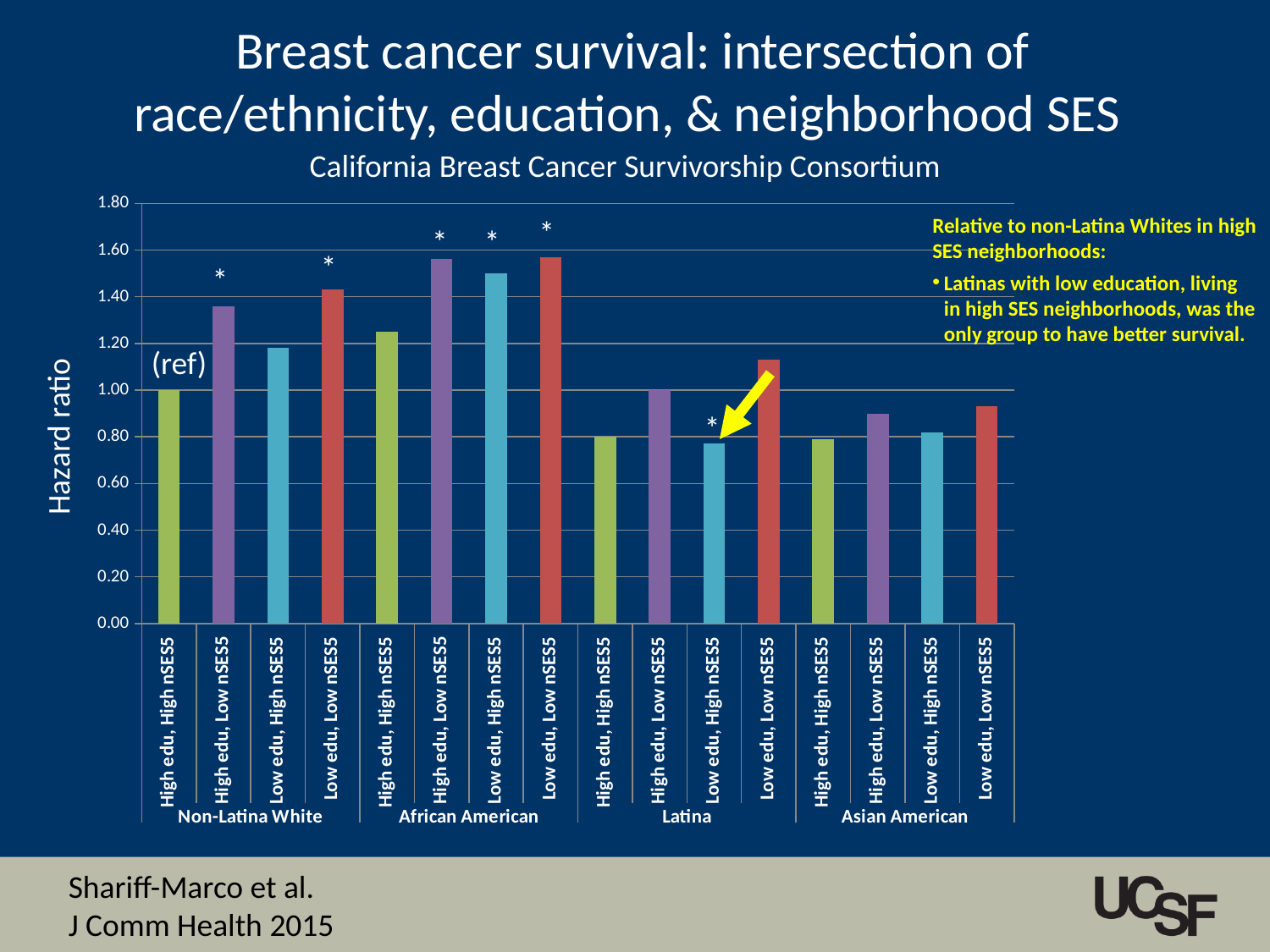
Is the hazard ratio for Latina, Low edu, High nSES greater or less than 1.00? less How many bars are plotted in the chart? 16 Which bar is marked as the reference group, labelled "(ref)"? Non-Latina White, High edu, High nSES5 Which has the higher hazard ratio: Non-Latina White, Low edu, Low nSES or Latina, Low edu, Low nSES? Non-Latina White, Low edu, Low nSES Is the hazard ratio for Asian American, High edu, Low nSES greater or less than 1.00? less How many race/ethnicity groups are shown along the x axis? 4 Is the hazard ratio for African American, Low edu, Low nSES greater or less than 1.40? greater What is the hazard ratio for the reference group (Non-Latina White, High edu, High nSES)? 1.00 What is the label of the y axis? Hazard ratio What kind of chart is shown on the slide? bar chart Which race/ethnicity group has the highest hazard ratios overall? African American